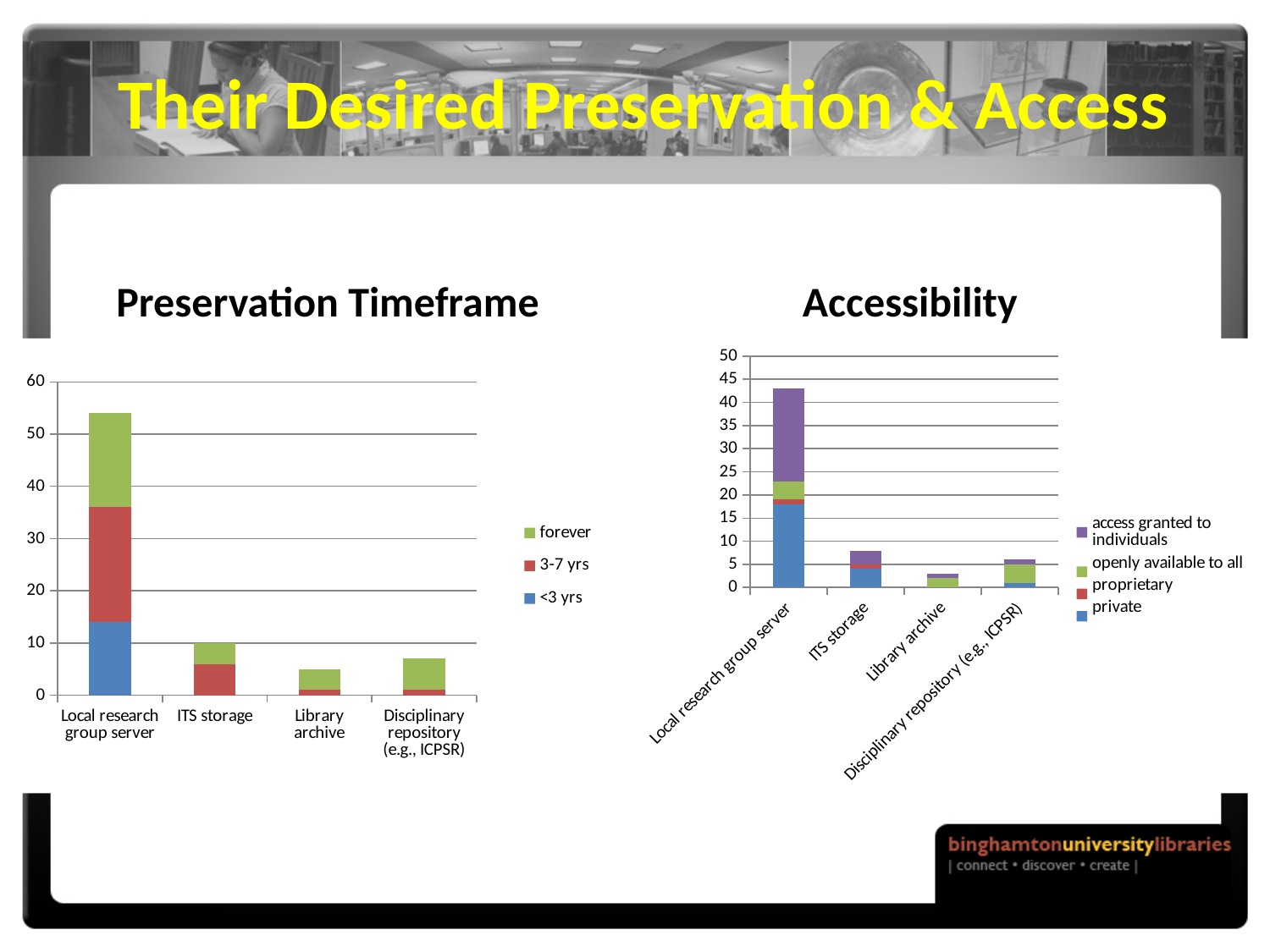
In the Accessibility chart, is the total for Local research group server greater or less than 40? greater In the Preservation Timeframe chart, which category has the shortest stacked bar? Library archive In the Accessibility chart, which category has the tallest stacked bar? Local research group server How many series does the legend of the Accessibility chart list? 4 How many series does the legend of the Preservation Timeframe chart list? 3 In the Preservation Timeframe chart, is the total for Local research group server greater or less than 50? greater How many categories are shown on the x axis of the Preservation Timeframe chart? 4 What are the legend entries of the Accessibility chart? access granted to individuals, openly available to all, proprietary, private In the Accessibility chart, which has the larger total: ITS storage or Library archive? ITS storage What kind of chart is the Preservation Timeframe chart? bar chart In the Preservation Timeframe chart, which category has the tallest stacked bar? Local research group server In the Preservation Timeframe chart, is the total for ITS storage greater or less than 20? less